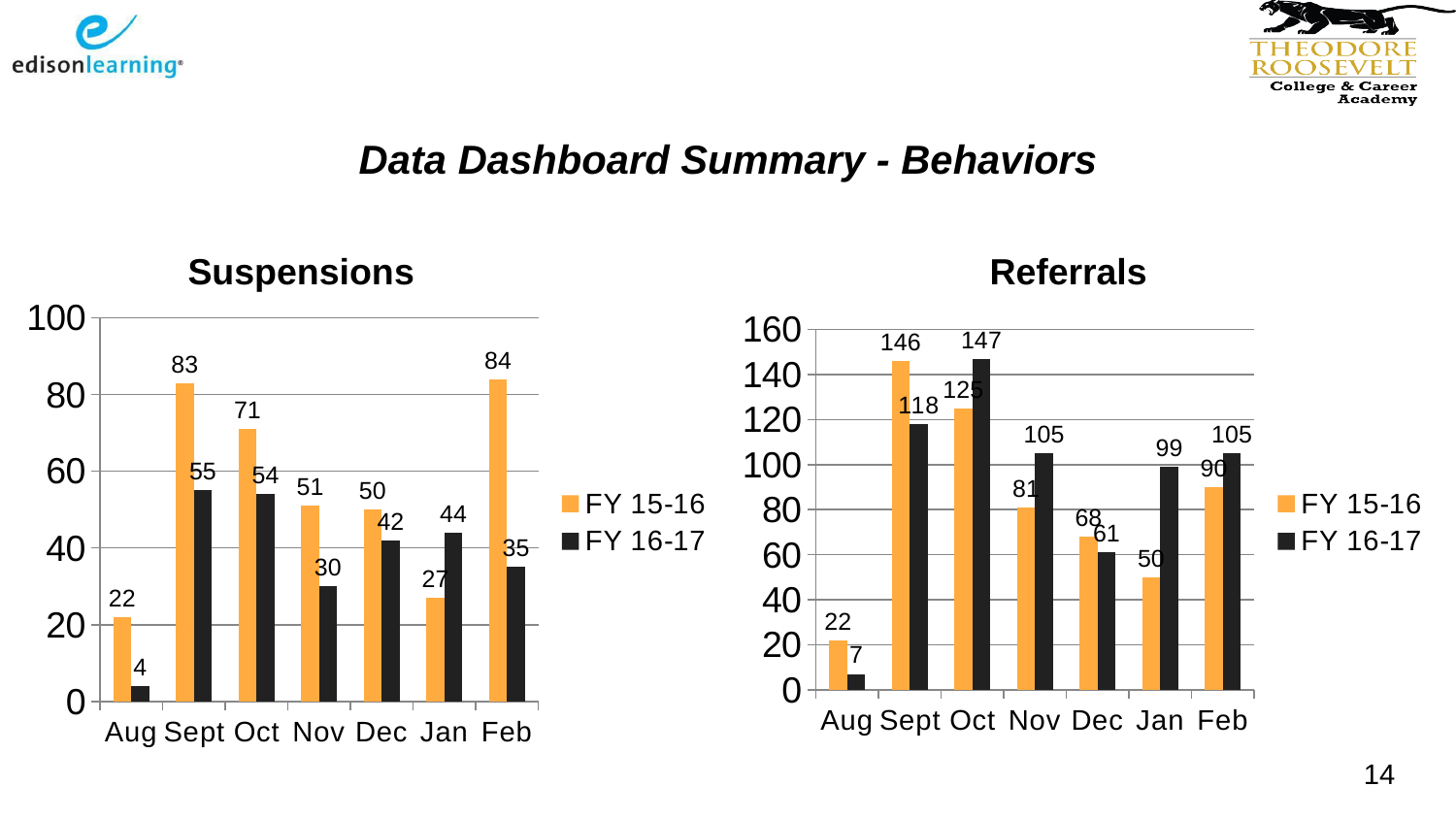
How many months are shown on the x axis of the Referrals chart? 7 In the Suspensions chart, what is the value for FY 16-17 in Jan? 44 In the Suspensions chart, what is the difference between FY 15-16 and FY 16-17 in Oct? 17 In the Suspensions chart, which is larger in Jan: FY 15-16 or FY 16-17? FY 16-17 In the Suspensions chart, what is the value for FY 15-16 in Sept? 83 In the Referrals chart, which month has the lowest FY 15-16 value? Aug In the Referrals chart, which month has the highest FY 16-17 value? Oct How many series does the legend of the Suspensions chart list? 2 What type of chart is the Referrals chart? Bar chart In the Referrals chart, what is the value for FY 16-17 in Nov? 105 In the Suspensions chart, which month has the lowest FY 16-17 value? Aug In the Referrals chart, what is the difference between FY 15-16 and FY 16-17 in Jan? 49